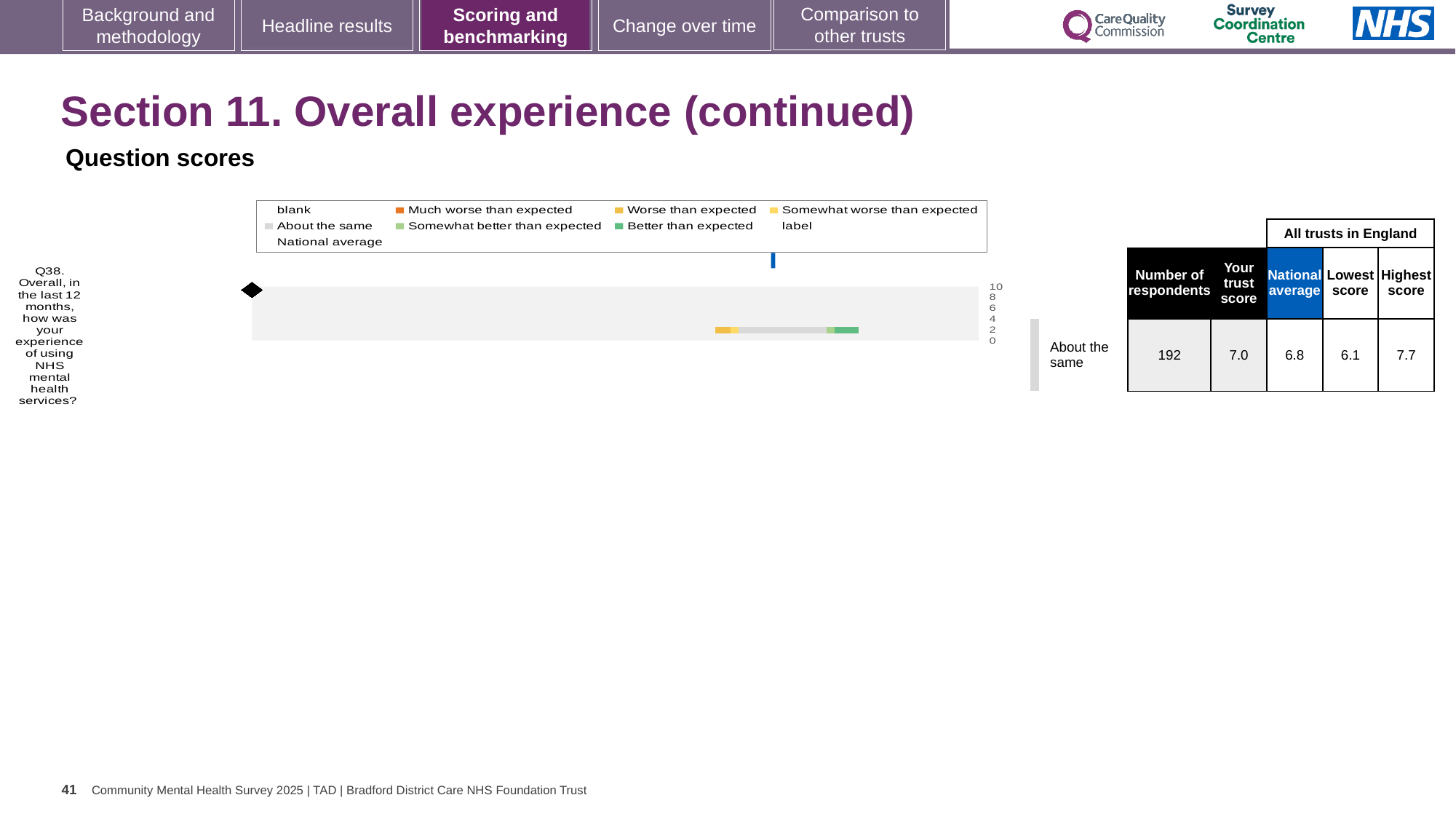
Which is larger for Q38, the trust score or the national average? Trust score How many questions are plotted on the chart? 1 What is the lowest score among all trusts in England for Q38? 6.1 What is the highest score among all trusts in England for Q38? 7.7 Which benchmark category is the trust's Q38 score placed in? About the same What is the difference between the trust score and the national average for Q38? 0.2 What is the difference between the highest and lowest trust scores in England for Q38? 1.6 What is the trust score for Q38 (Overall, in the last 12 months, how was your experience of using NHS mental health services?)? 7.0 How many respondents answered Q38? 192 What is the national average score for Q38? 6.8 What is the maximum value shown on the chart's score axis? 10 What kind of chart is used to show the Q38 question score? Bar chart